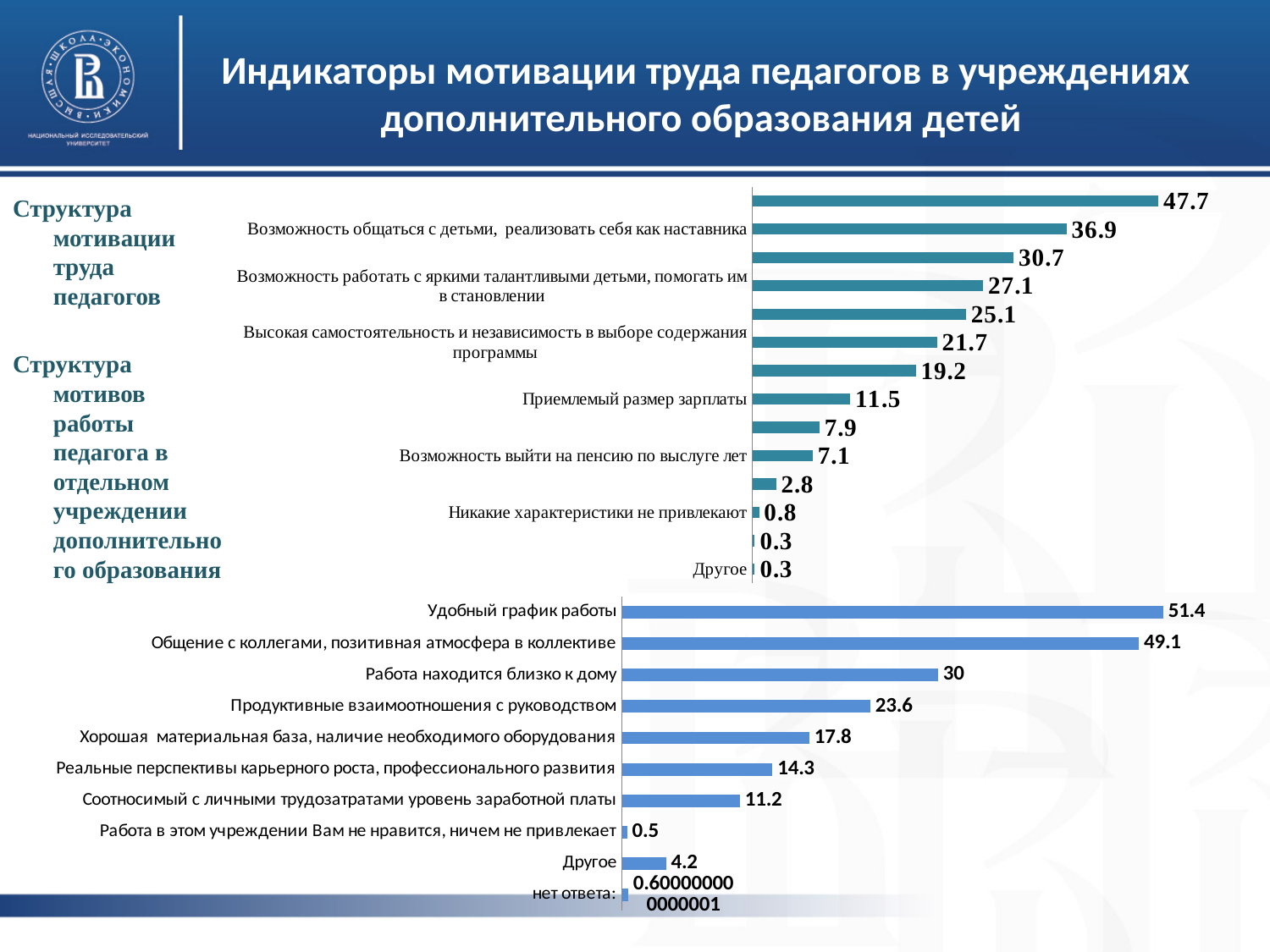
In the bottom chart, what is the value for 'Другое'? 4.2 In the top chart, what is the highest value shown? 47.7 In the bottom chart, what is the difference between 'Удобный график работы' and 'Общение с коллегами, позитивная атмосфера в коллективе'? 2.3 How many categories are shown in the bottom chart? 10 In the bottom chart, which category has the lowest value? Работа в этом учреждении Вам не нравится, ничем не привлекает What type of chart is the bottom chart? Bar chart In the bottom chart, which is larger: 'Продуктивные взаимоотношения с руководством' or 'Хорошая материальная база, наличие необходимого оборудования'? Продуктивные взаимоотношения с руководством In the bottom chart, which category has the highest value? Удобный график работы How many bars are shown in the top chart? 14 In the bottom chart, what is the value for 'Реальные перспективы карьерного роста, профессионального развития'? 14.3 In the bottom chart, what is the value for 'Работа находится близко к дому'? 30 In the bottom chart, what is the value for 'Удобный график работы'? 51.4